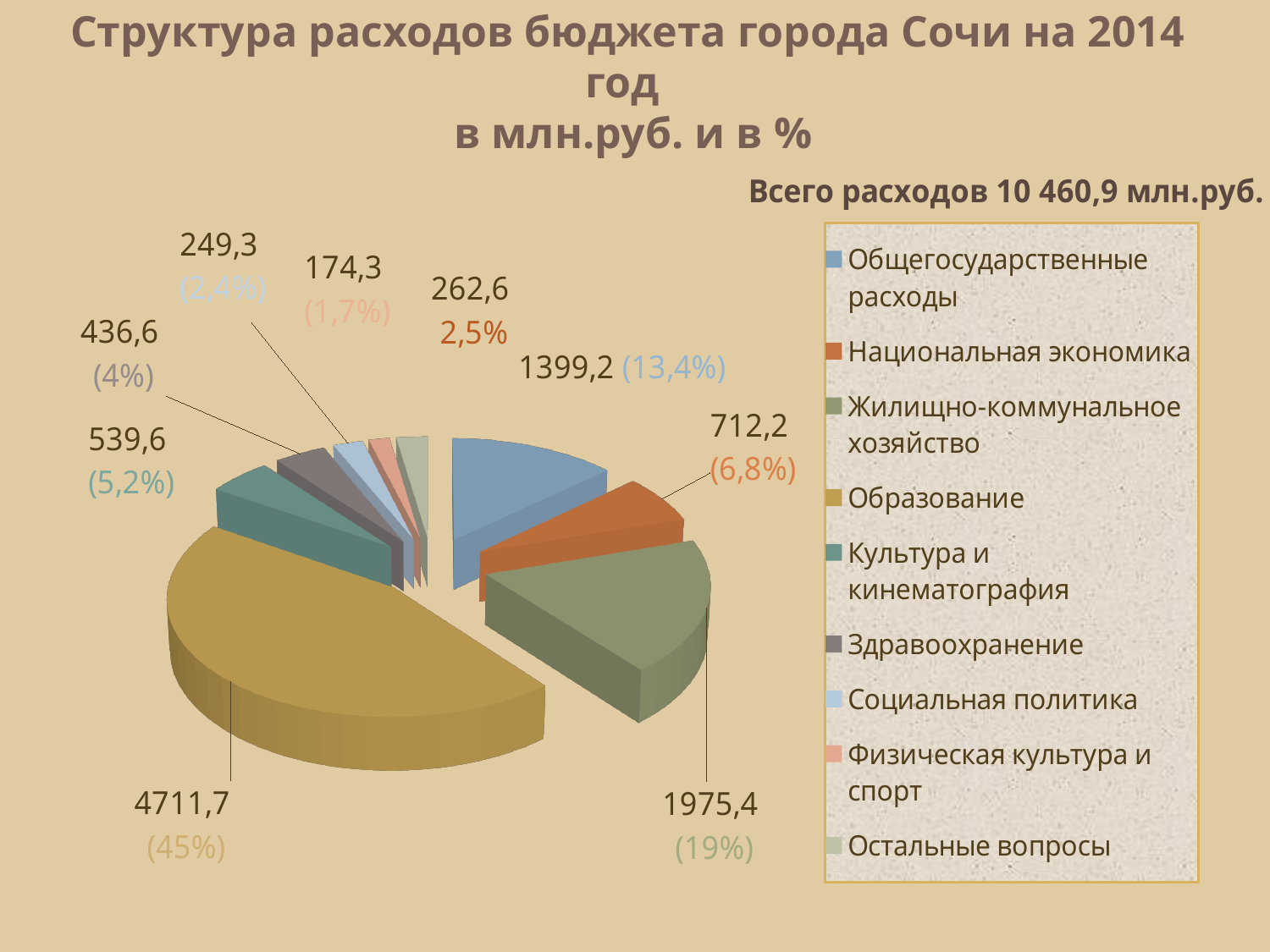
What percentage share does Национальная экономика have? 6,8% Which category has the smallest share of the pie? Физическая культура и спорт Which is larger, Культура и кинематография or Здравоохранение? Культура и кинематография How many categories does the legend of the pie chart list? 9 What is the value in million rubles for Социальная политика? 249,3 What percentage share does Жилищно-коммунальное хозяйство have? 19% What is the value in million rubles for Образование? 4711,7 What is the total expenditure stated on the slide? 10 460,9 млн.руб. Which category has the largest share of the pie? Образование What is the difference in million rubles between Образование and Жилищно-коммунальное хозяйство? 2736,3 What is the value in million rubles for Общегосударственные расходы? 1399,2 What type of chart is shown on the slide? pie chart